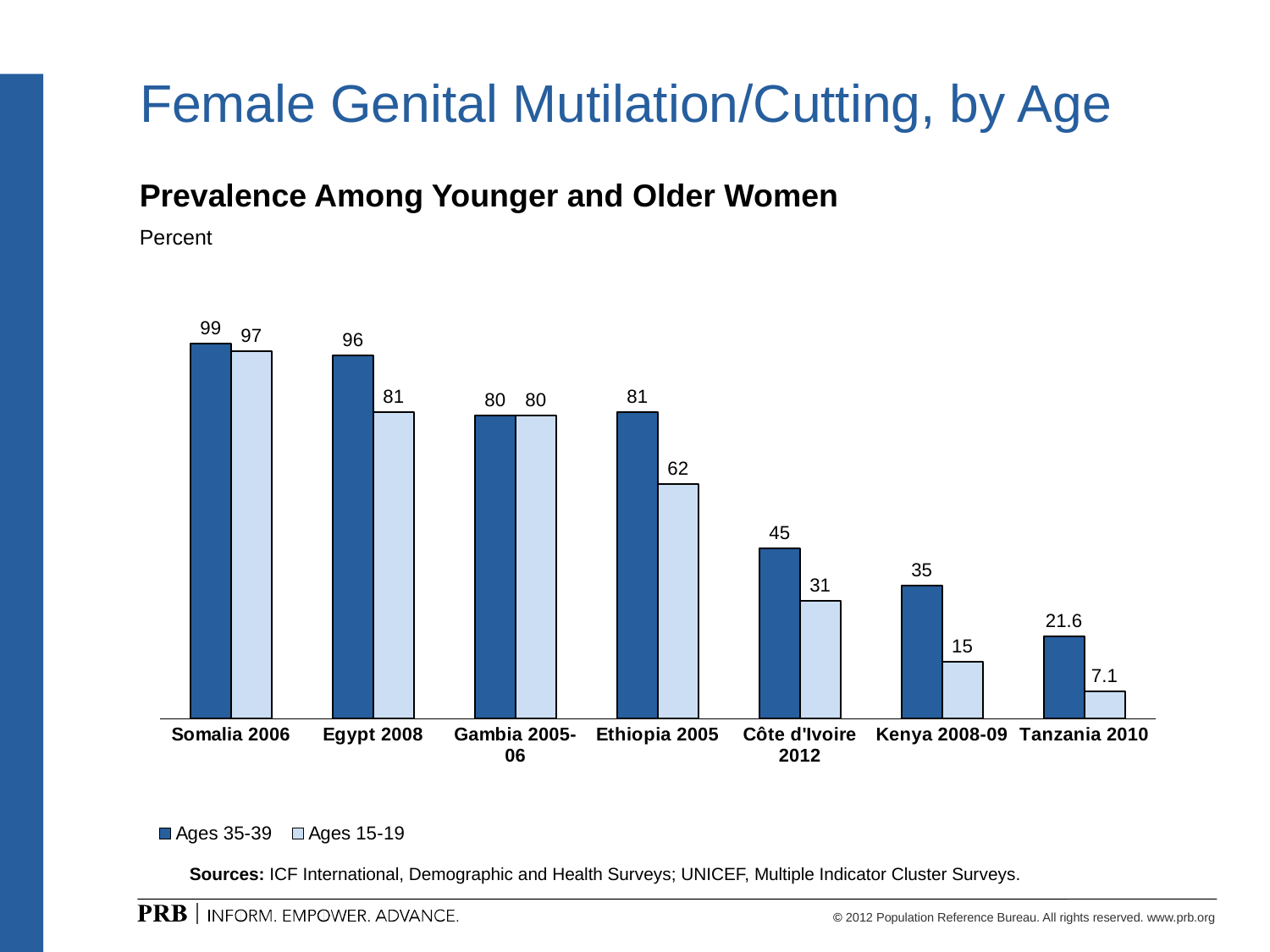
What is the value for Ages 15-19 in Tanzania 2010? 7.1 Which country has the lowest value for Ages 15-19? Tanzania 2010 Which is larger for Côte d'Ivoire 2012: the value for Ages 35-39 or Ages 15-19? Ages 35-39 What is the value for Ages 15-19 in Ethiopia 2005? 62 What is the value for Ages 35-39 in Somalia 2006? 99 How many series does the legend list? 2 How many countries are shown on the x axis? 7 Which country has the highest value for Ages 35-39? Somalia 2006 What is the difference between the Ages 35-39 and Ages 15-19 values for Kenya 2008-09? 20 What is the difference between the Ages 35-39 and Ages 15-19 values for Egypt 2008? 15 Do the Ages 35-39 values rise or fall from Somalia 2006 to Tanzania 2010? Fall What kind of chart is shown on the slide? Bar chart